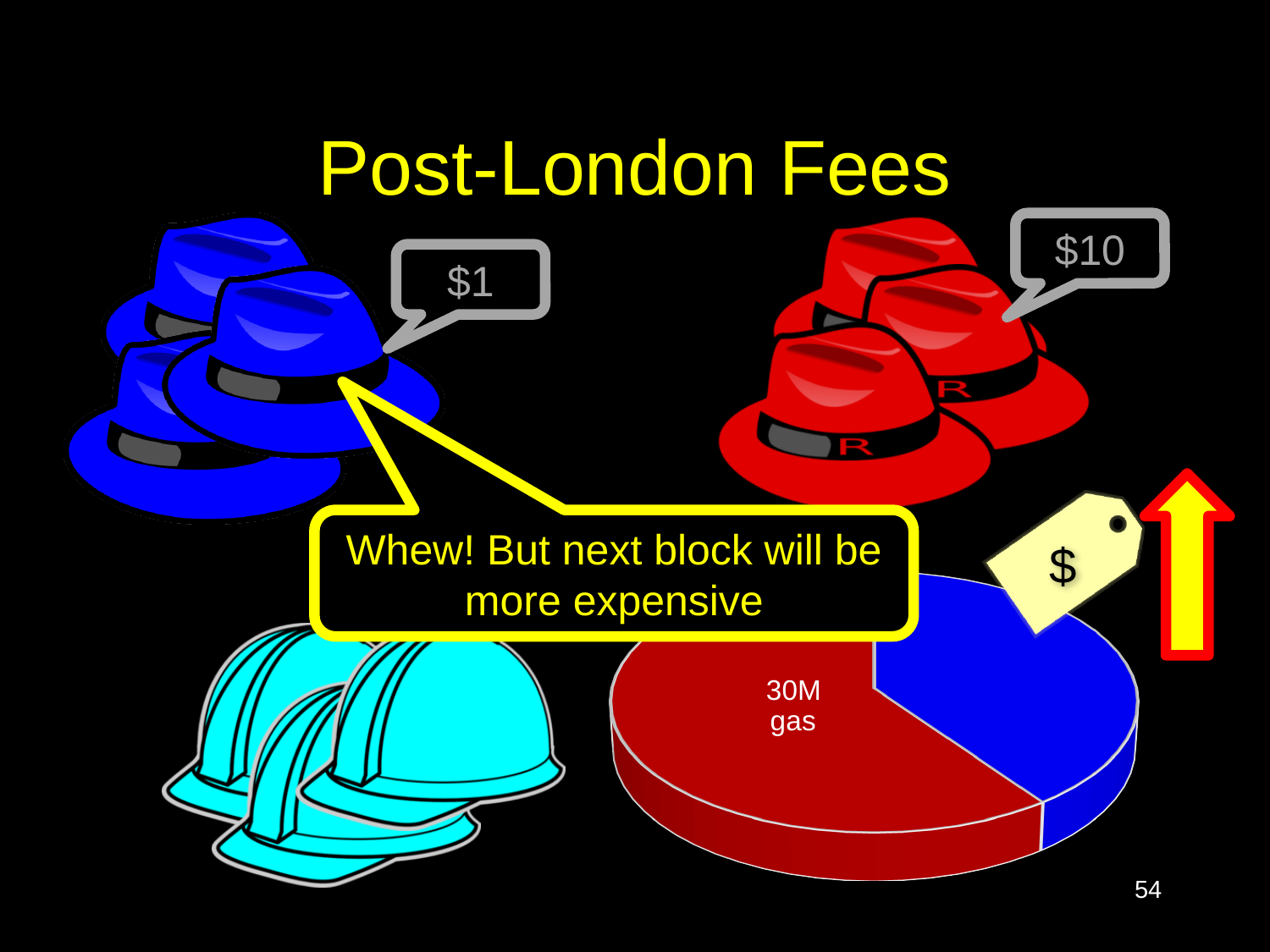
What kind of chart is shown at the bottom right of the slide? pie chart Which slice of the pie chart is larger, the red one or the blue one? red How many slices does the pie chart have? 2 Which colour slice takes up the smallest share of the pie chart? blue What two colours are used for the slices of the pie chart? red and blue Which colour slice takes up the largest share of the pie chart? red Is the red slice of the pie chart more or less than half of the pie? more What is the title of the slide containing the pie chart? Post-London Fees What label is printed on the red slice of the pie chart? 30M gas